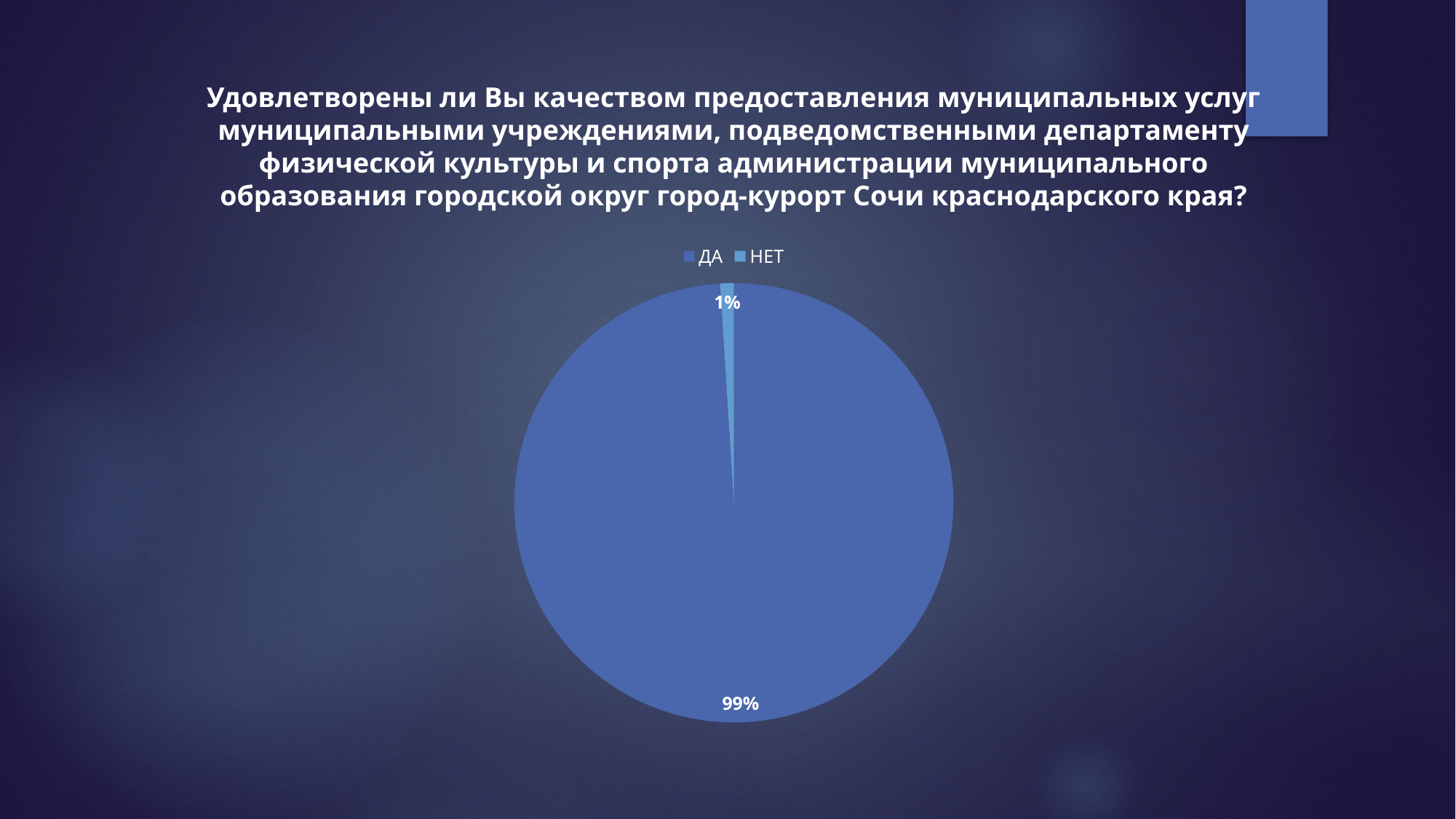
What type of chart is shown on the slide? pie chart Which category has the smallest slice of the pie? НЕТ How many categories does the pie chart show? 2 Which is larger, the ДА slice or the НЕТ slice? ДА Which category has the largest slice of the pie? ДА What is the difference between the ДА and НЕТ shares? 98% What share of the pie does НЕТ represent? 1% What share of the pie does ДА represent? 99% How many entries does the legend list? 2 Is the share for ДА greater or less than 50%? greater What are the two legend entries of the chart? ДА and НЕТ